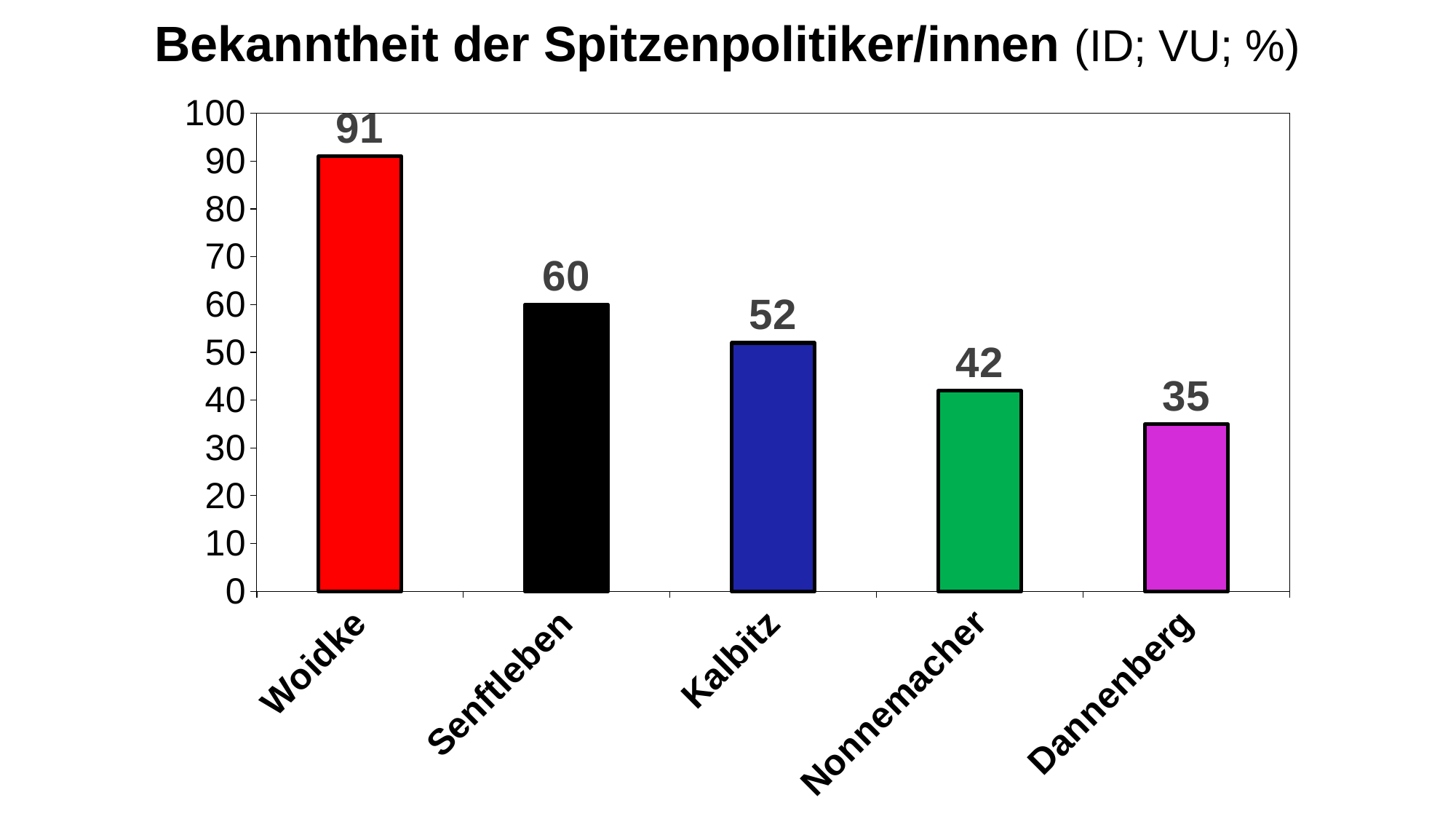
Which politician has the highest value? Woidke How many politicians are shown on the chart? 5 What is the difference between the values for Woidke and Senftleben? 31 What is the value for Senftleben? 60 What is the value for Dannenberg? 35 What is the value for Kalbitz? 52 Do the values rise or fall from left to right along the x axis? Fall What is the value for Woidke? 91 Which politician has the lowest value? Dannenberg Which is larger, the value for Kalbitz or the value for Nonnemacher? Kalbitz What kind of chart is this? Bar chart What is the value for Nonnemacher? 42